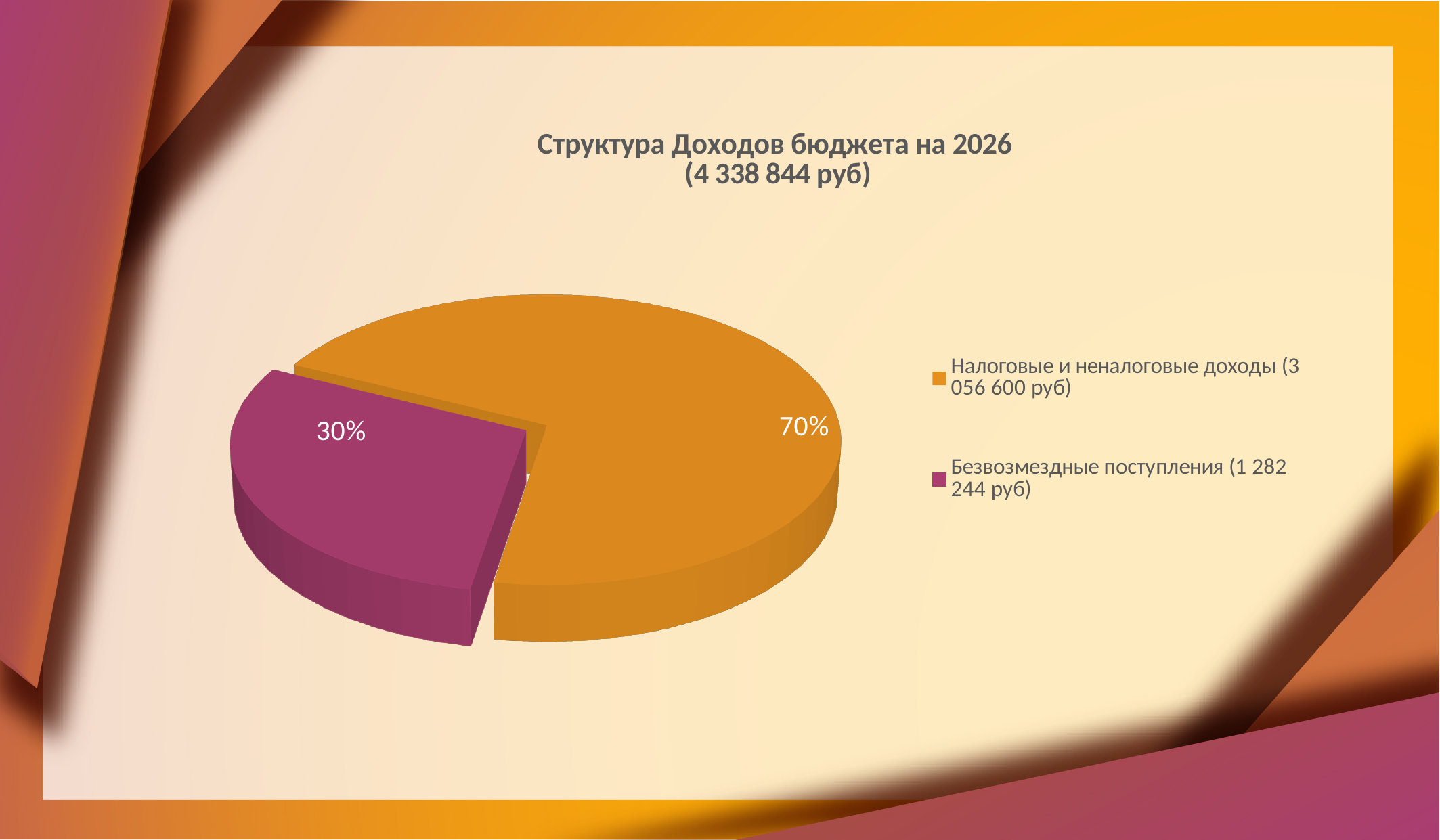
Which category has the largest slice of the pie? Налоговые и неналоговые доходы Which slice is larger: "Налоговые и неналоговые доходы" or "Безвозмездные поступления"? Налоговые и неналоговые доходы What is the title of the chart? Структура Доходов бюджета на 2026 (4 338 844 руб) What is the difference in percentage points between the two slices? 40 What share of the pie does "Безвозмездные поступления" take? 30% What kind of chart is shown on the slide? Pie chart What colour is the slice for "Безвозмездные поступления"? Purple What share of the pie does "Налоговые и неналоговые доходы" take? 70% Which category has the smallest slice of the pie? Безвозмездные поступления What amount in rubles is given in the legend for "Налоговые и неналоговые доходы"? 3 056 600 руб How many entries does the legend list? 2 How many slices does the pie chart have? 2